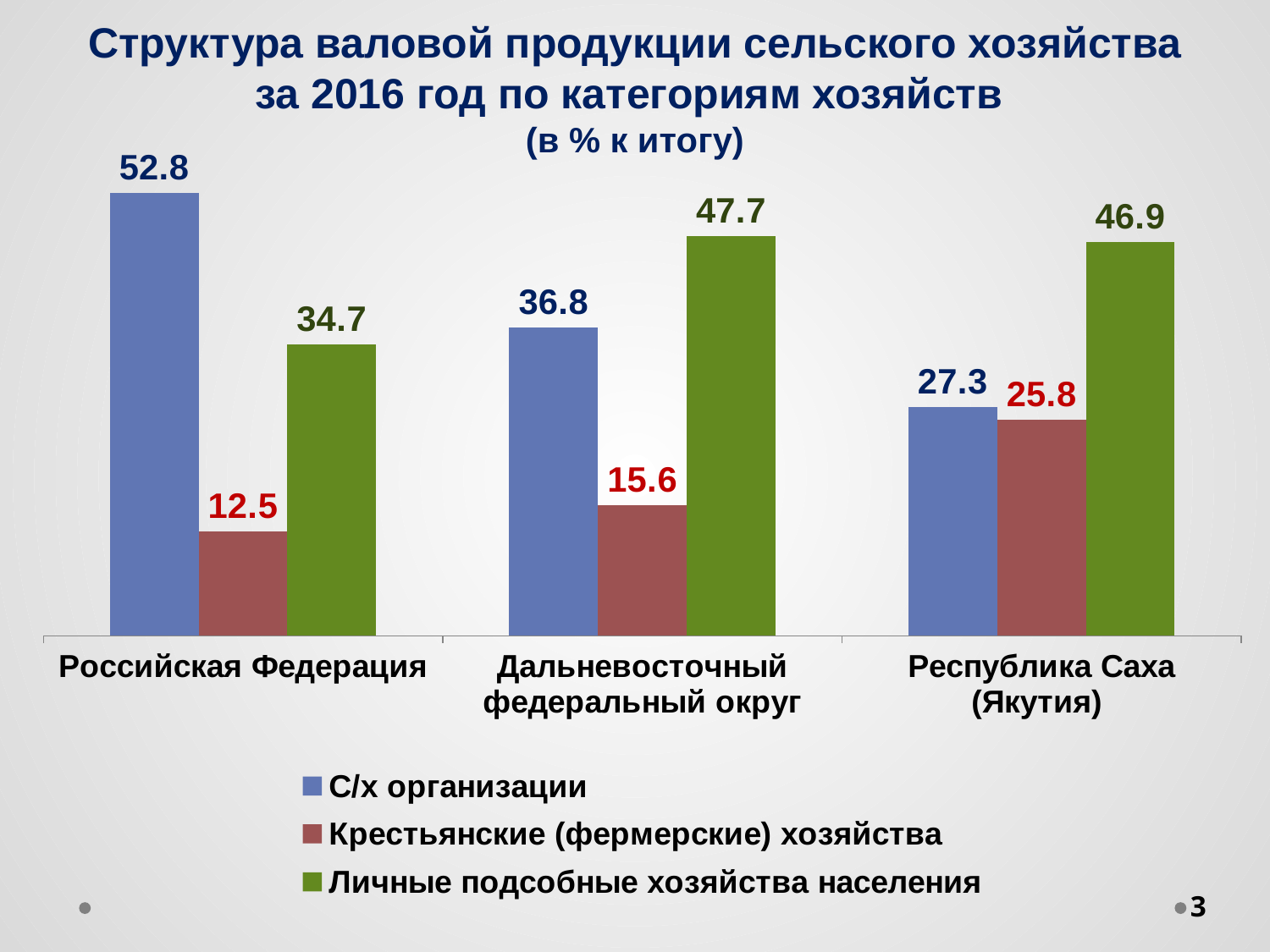
Which category has the lowest value for Крестьянские (фермерские) хозяйства? Российская Федерация Do the values for С/х организации rise or fall from Российская Федерация to Республика Саха (Якутия)? Fall What is the value for Личные подсобные хозяйства населения in Республика Саха (Якутия)? 46.9 What kind of chart is shown on the slide? Bar chart Which colour represents Личные подсобные хозяйства населения in the legend? Green What is the value for Крестьянские (фермерские) хозяйства in Дальневосточный федеральный округ? 15.6 How many series does the legend list? 3 How many categories are shown on the x axis? 3 What is the difference between Личные подсобные хозяйства населения and С/х организации in Дальневосточный федеральный округ? 10.9 Which category has the highest value for С/х организации? Российская Федерация Which is larger in Республика Саха (Якутия): С/х организации or Крестьянские (фермерские) хозяйства? С/х организации What is the value for С/х организации in Российская Федерация? 52.8